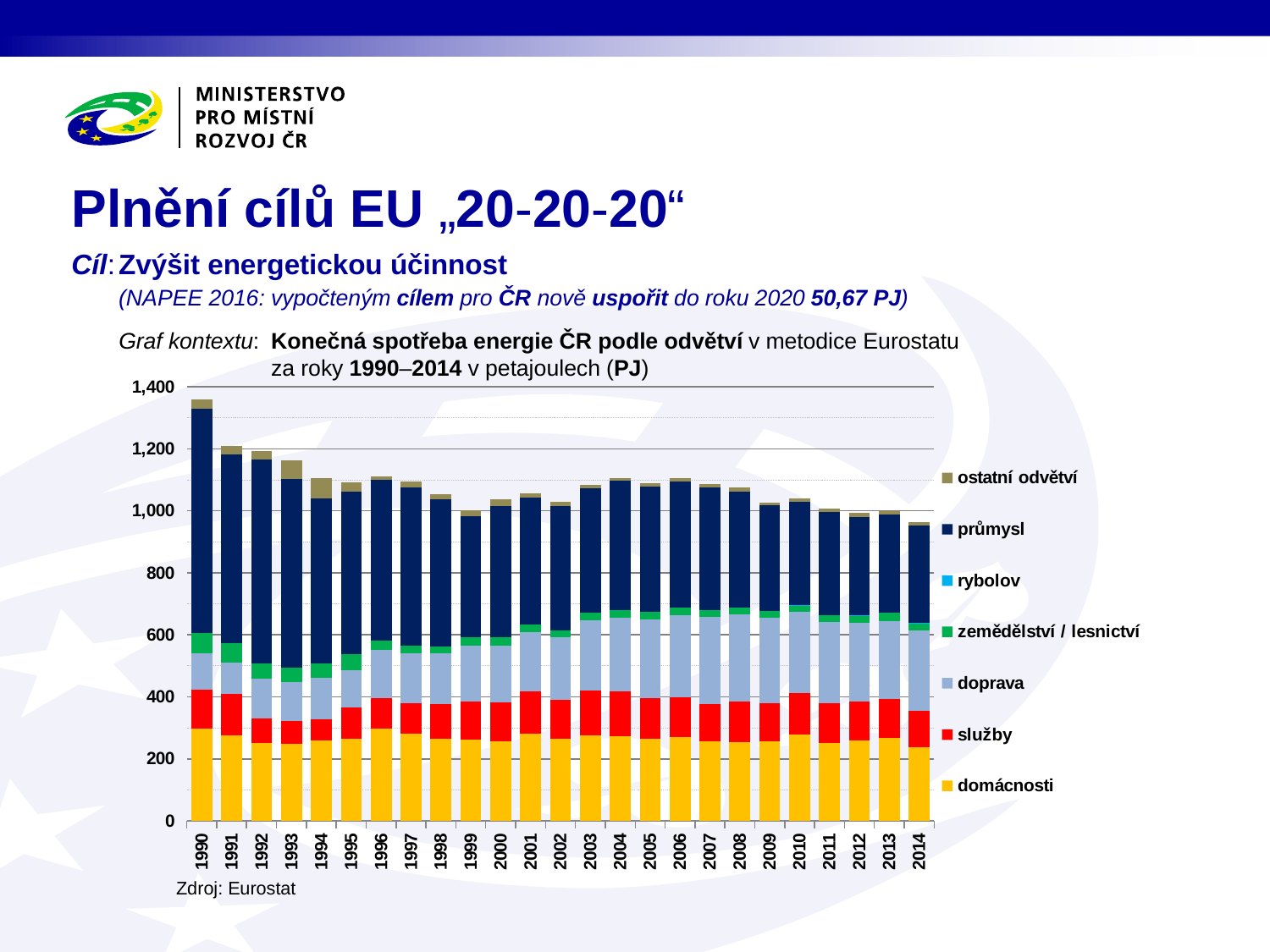
What kind of chart is shown on the slide? stacked bar chart Which year has the larger total, 1990 or 2014? 1990 Which year has the highest total final energy consumption? 1990 Is the total value for 2004 greater or less than 1,000? greater What is the source of the data cited below the chart? Eurostat Which series is shown at the bottom of each stacked bar? domácnosti Is the total value for 2014 greater or less than 1,000? less How many years (bars) are plotted on the chart? 25 Is the total value for 1990 greater or less than 1,200? greater Does the total final energy consumption generally rise or fall from 1990 to 2014? fall How many series does the chart legend list? 7